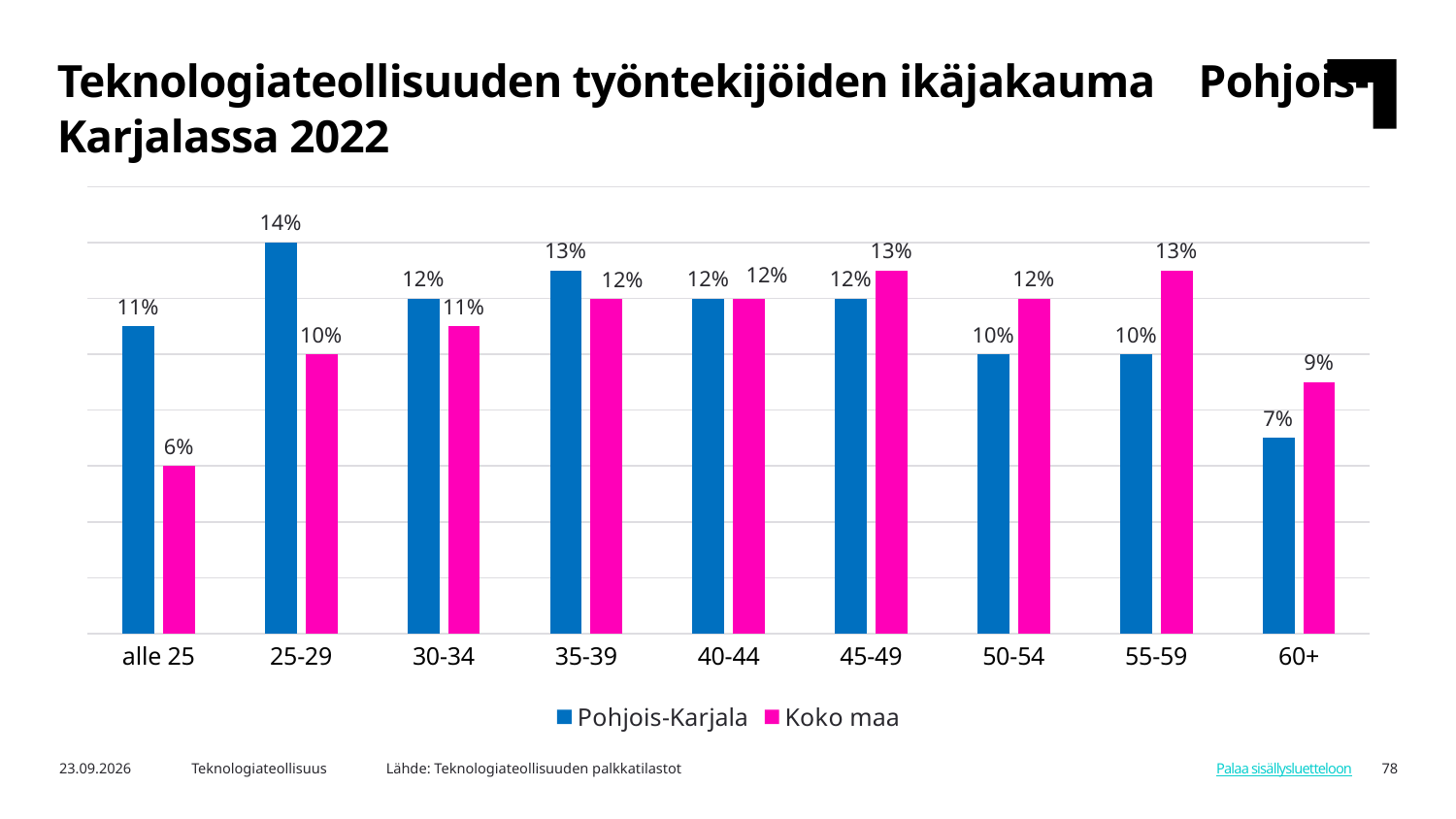
Which age group has the highest value for Pohjois-Karjala? 25-29 What is the value for Koko maa in the 60+ age group? 9% Which age group has the lowest value for Koko maa? alle 25 What is the value for Koko maa in the 50-54 age group? 12% How many series does the legend list? 2 How many age groups are shown on the x axis? 9 What is the difference between Pohjois-Karjala and Koko maa in the 25-29 age group? 4 percentage points In the 55-59 age group, which is larger: Pohjois-Karjala or Koko maa? Koko maa What kind of chart is shown on the slide? Bar chart Which age group has the lowest value for Pohjois-Karjala? 60+ What is the value for Pohjois-Karjala in the alle 25 age group? 11% What is the difference between Pohjois-Karjala and Koko maa in the alle 25 age group? 5 percentage points